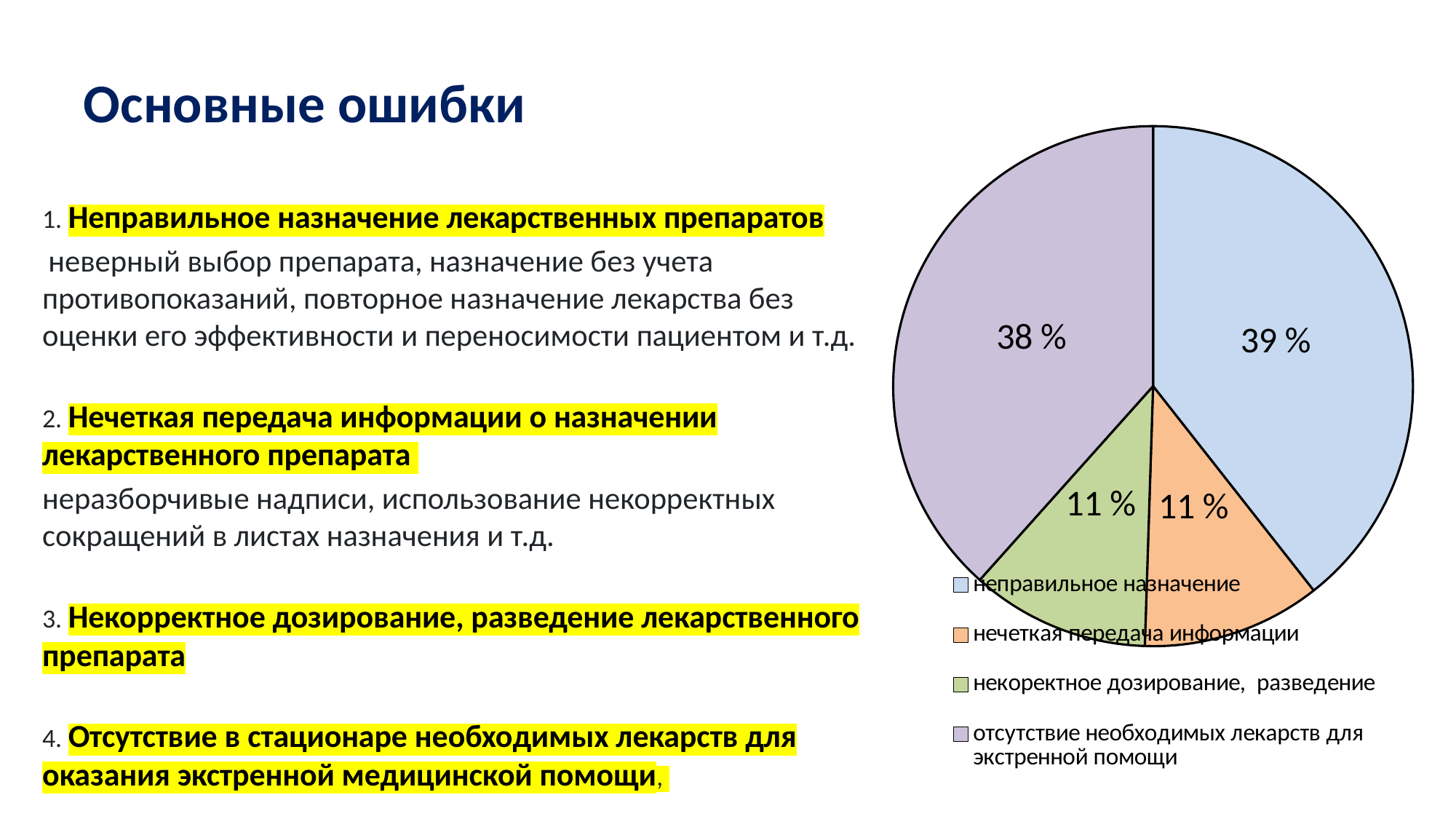
What kind of chart is shown on the slide? pie chart What share of the pie chart is labelled "отсутствие необходимых лекарств для экстренной помощи"? 38 % Which category has the largest slice in the pie chart? неправильное назначение What colour is the slice for "некоректное дозирование, разведение" in the pie chart? green What is the combined share of "нечеткая передача информации" and "некоректное дозирование, разведение"? 22 % What is the smallest percentage shown on the pie chart? 11 % Which is larger: the slice for "неправильное назначение" or the slice for "отсутствие необходимых лекарств для экстренной помощи"? неправильное назначение By how many percentage points does "неправильное назначение" exceed "отсутствие необходимых лекарств для экстренной помощи"? 1 What share of the pie chart is labelled "некоректное дозирование, разведение"? 11 % What share of the pie chart is labelled "нечеткая передача информации"? 11 % How many slices does the pie chart have? 4 What share of the pie chart is labelled "неправильное назначение"? 39 %